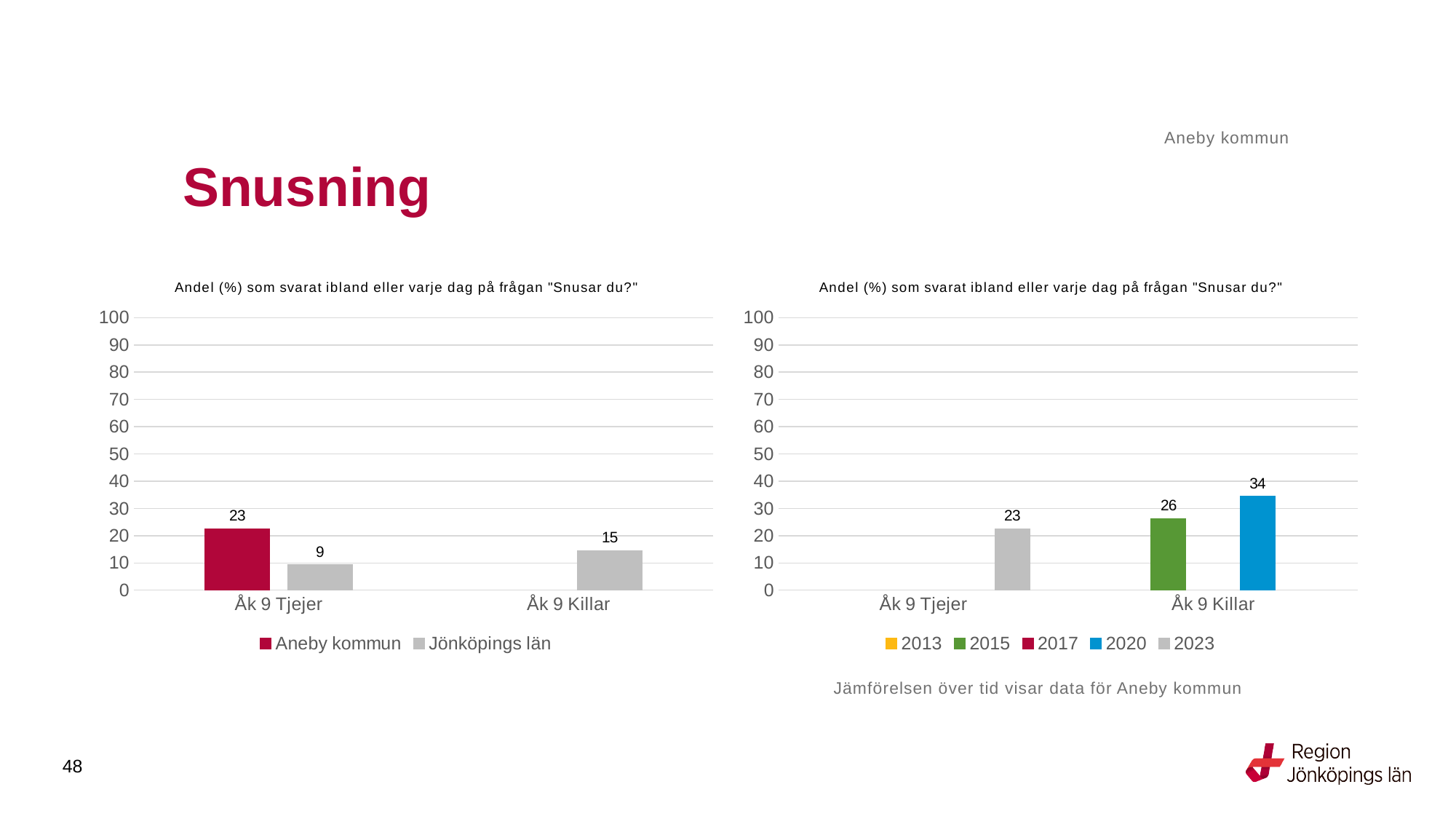
In the left chart, which is larger for Åk 9 Tjejer: Aneby kommun or Jönköpings län? Aneby kommun In the left chart, what is the value for Jönköpings län for Åk 9 Tjejer? 9 In the left chart, what is the value for Aneby kommun for Åk 9 Tjejer? 23 In the left chart, what is the difference between Aneby kommun and Jönköpings län for Åk 9 Tjejer? 14 In the left chart, what is the value for Jönköpings län for Åk 9 Killar? 15 What kind of chart is the left chart? Bar chart In the right chart, what is the difference between the 2020 and 2015 values for Åk 9 Killar? 8 In the right chart, how many series does the legend list? 5 In the right chart, what is the value for 2023 for Åk 9 Tjejer? 23 In the right chart, what is the value for 2015 for Åk 9 Killar? 26 In the right chart, what is the value for 2020 for Åk 9 Killar? 34 In the left chart, how many series does the legend list? 2